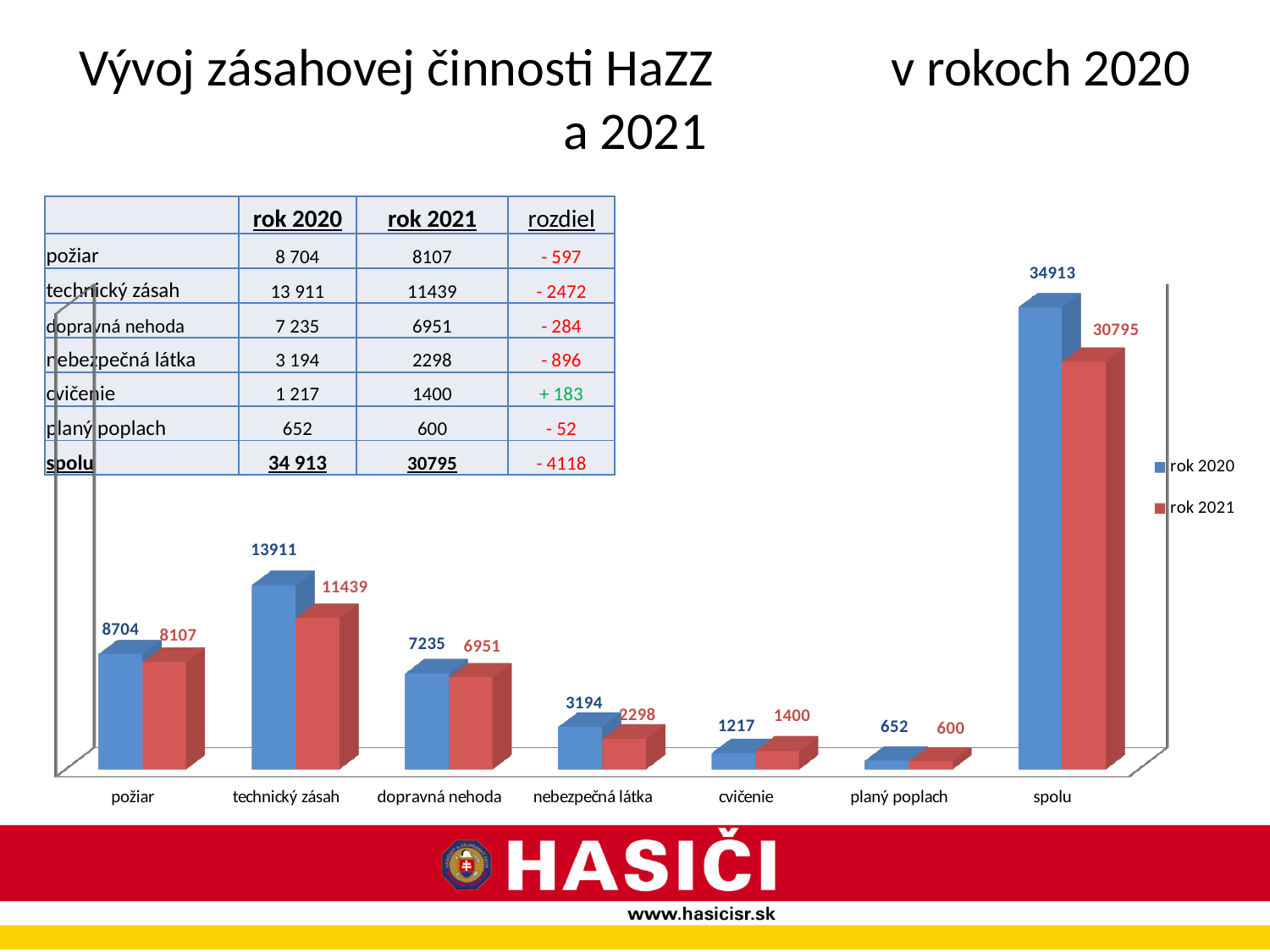
What is the difference between the rok 2020 and rok 2021 values for požiar? 597 Excluding spolu, which category has the highest rok 2020 value? technický zásah What is the value for cvičenie in the rok 2021 series? 1400 Which colour represents the rok 2021 series in the chart? red How many series does the legend list? 2 Which is larger for cvičenie: the rok 2020 value or the rok 2021 value? rok 2021 What is the difference between the rok 2020 and rok 2021 values for nebezpečná látka? 896 Which category has the lowest rok 2021 value? planý poplach What is the value for technický zásah in the rok 2020 series? 13911 What kind of chart is shown on the slide? bar chart How many categories are shown on the x axis of the chart? 7 What is the value for spolu in the rok 2021 series? 30795